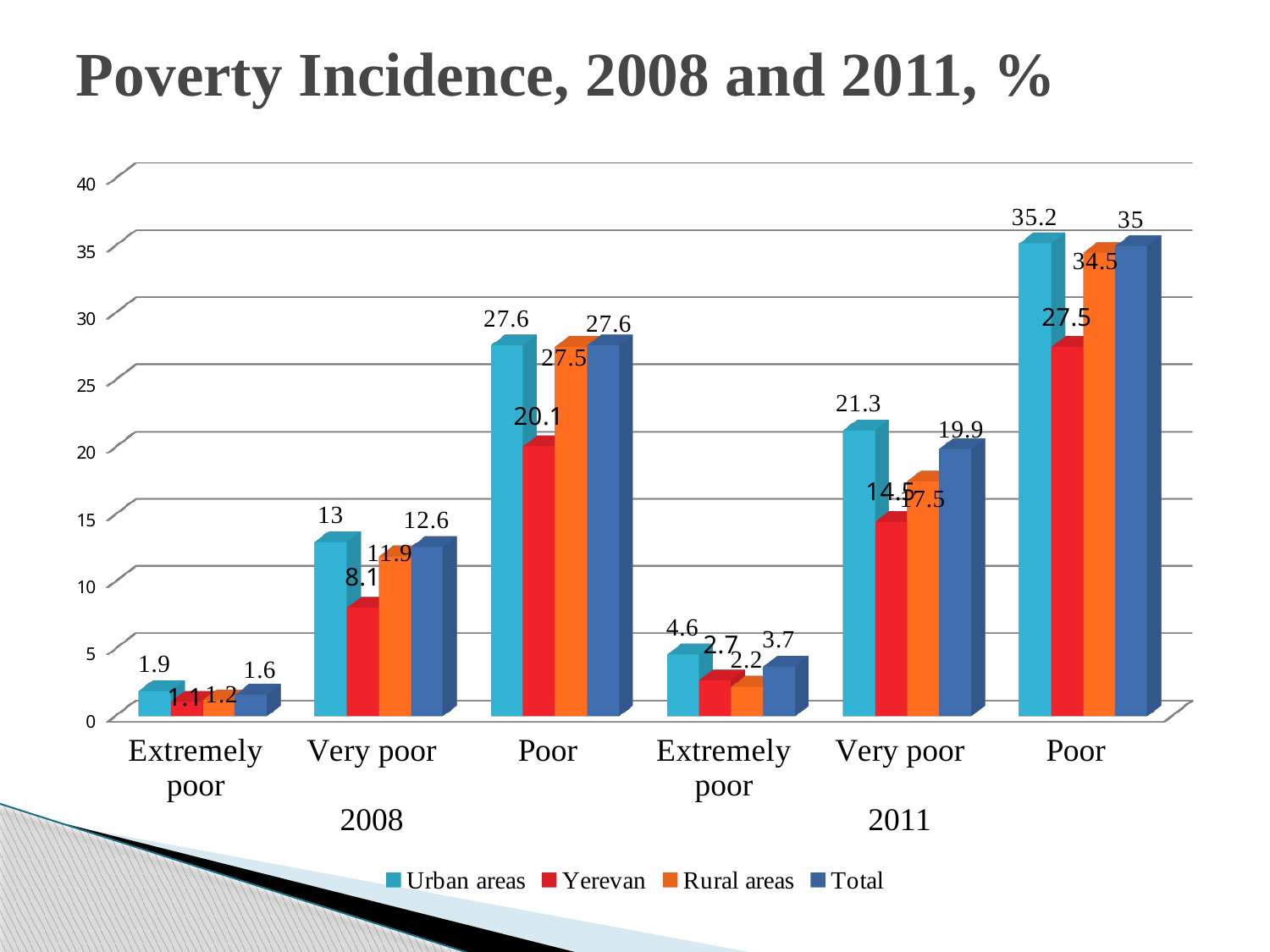
What is the Rural areas value for Extremely poor in 2011? 2.2 Does the Total value rise or fall from Extremely poor to Poor within 2011? Rise How many series does the legend list? 4 What is the difference between the Total values for Poor in 2011 and Poor in 2008? 7.4 Which series has the highest value for Poor in 2008? Urban areas and Total (27.6) What is the Urban areas value for Poor in 2011? 35.2 Which is larger: the Urban areas value for Very poor in 2011 or the Rural areas value for Very poor in 2011? Urban areas What is the Yerevan value for Very poor in 2008? 8.1 What is the Total value for Very poor in 2011? 19.9 What is the title of the chart? Poverty Incidence, 2008 and 2011, % Which series has the lowest value for Very poor in 2011? Yerevan What kind of chart is shown on the slide? Bar chart